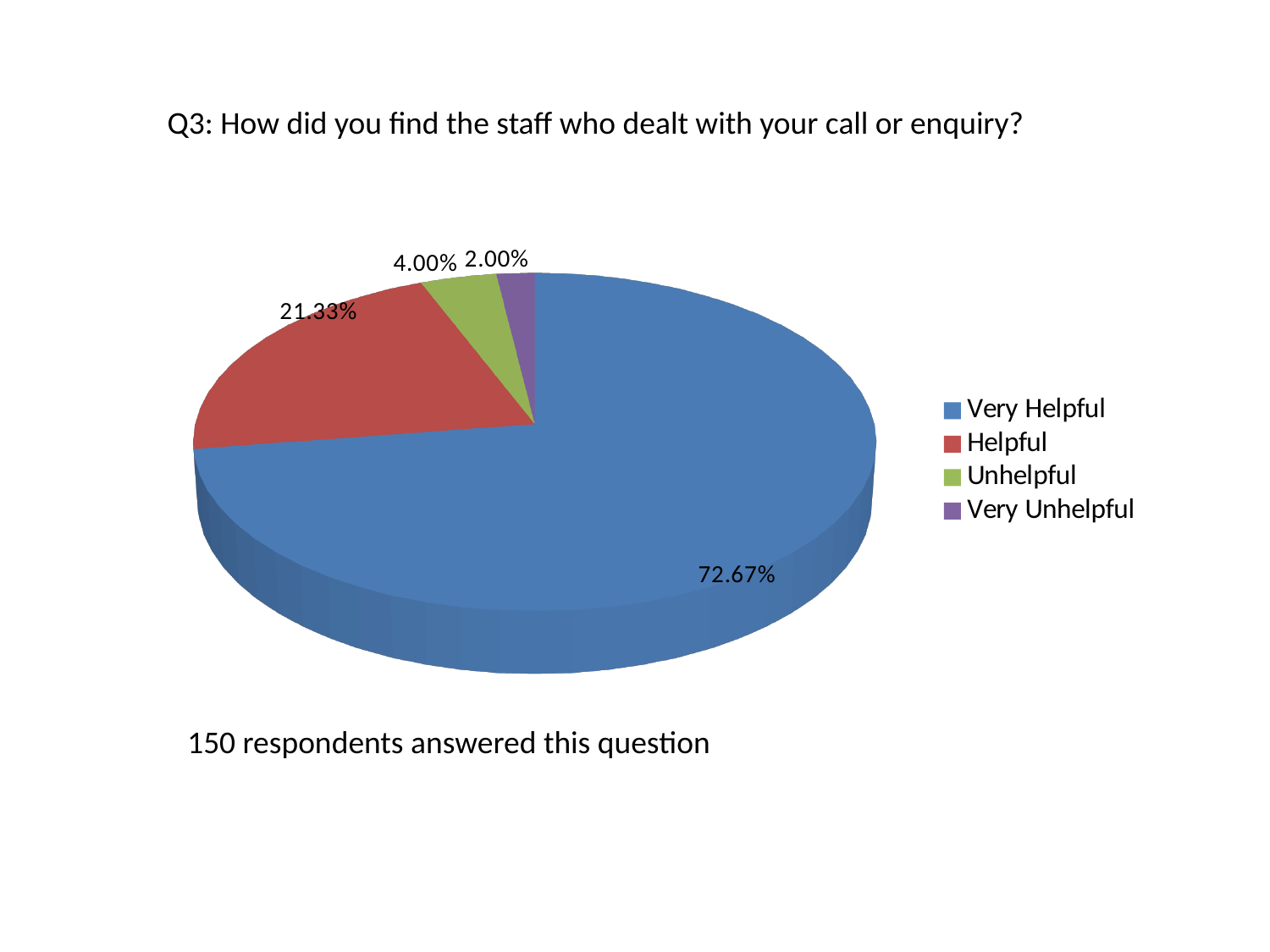
Which slice is larger, Unhelpful or Very Unhelpful? Unhelpful What percentage of respondents found the staff Very Helpful? 72.67% Which response category has the largest share of the pie? Very Helpful What percentage of respondents found the staff Helpful? 21.33% What kind of chart is shown on the slide? Pie chart How many respondents answered this question, according to the slide? 150 What percentage of respondents found the staff Very Unhelpful? 2.00% Which response category has the smallest share of the pie? Very Unhelpful How many categories does the pie chart show? 4 What is the difference in percentage points between the Very Helpful and Helpful slices? 51.34 What colour is the Helpful slice in the pie chart? Red What percentage of respondents found the staff Unhelpful? 4.00%